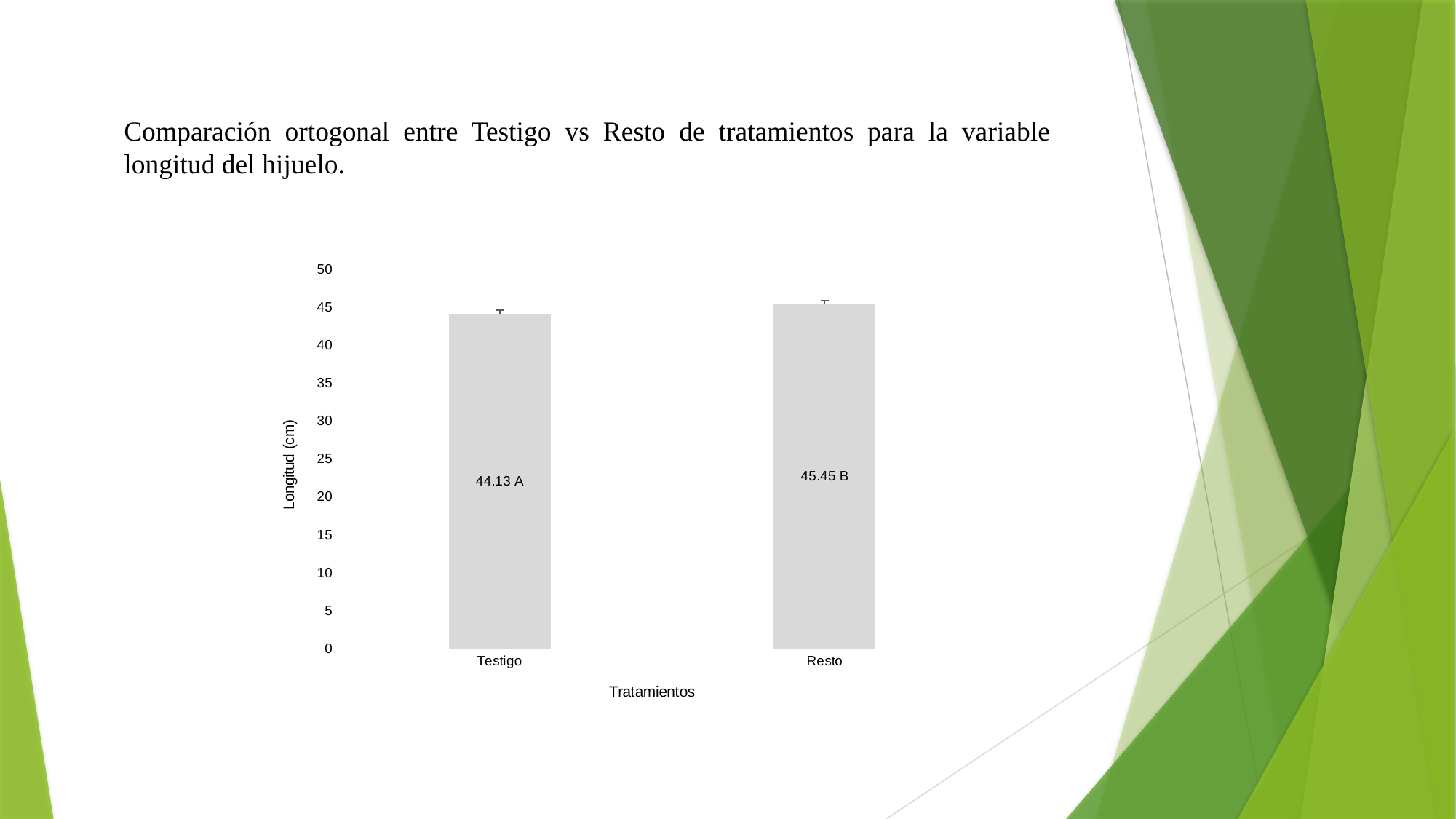
How many treatments are shown on the x axis? 2 Is the value for Testigo greater or less than 40? greater What is the difference between the values for Resto and Testigo? 1.32 What is the value shown for Testigo? 44.13 A Which treatment has the higher bar? Resto What is the value shown for Resto? 45.45 B Is the value for Resto greater or less than 50? less What kind of chart is shown on the slide? bar chart What is the label of the x axis? Tratamientos Which treatment has the lower bar? Testigo What is the label of the y axis? Longitud (cm)